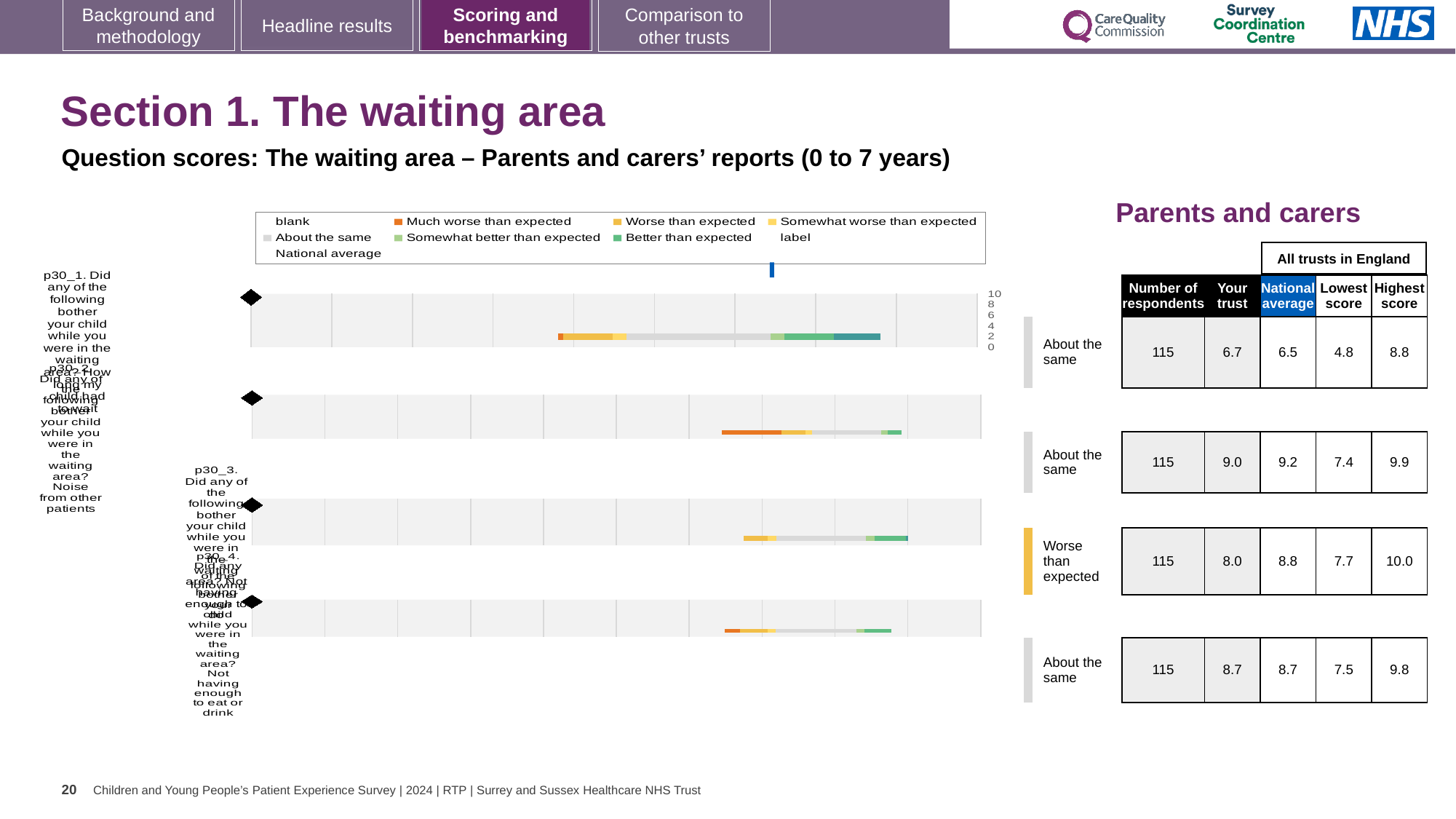
How many respondents are listed for each question row in the table? 115 Which legend entry is shown in dark green? Better than expected For the first row (p30_1), is the 'Your trust' score higher or lower than the national average? higher What kind of chart is shown on the slide? bar chart Which question row is rated 'Worse than expected' rather than 'About the same'? p30_3 (not having enough to do) In the table beside the chart, what is the highest score for the fourth row (p30_4, not having enough to eat or drink)? 9.8 For the second row (p30_2), what is the difference between the highest score and the lowest score in the table? 2.5 What colour does the legend use for 'Much worse than expected'? orange How many question rows (p30_1 to p30_4) are plotted in the chart? 4